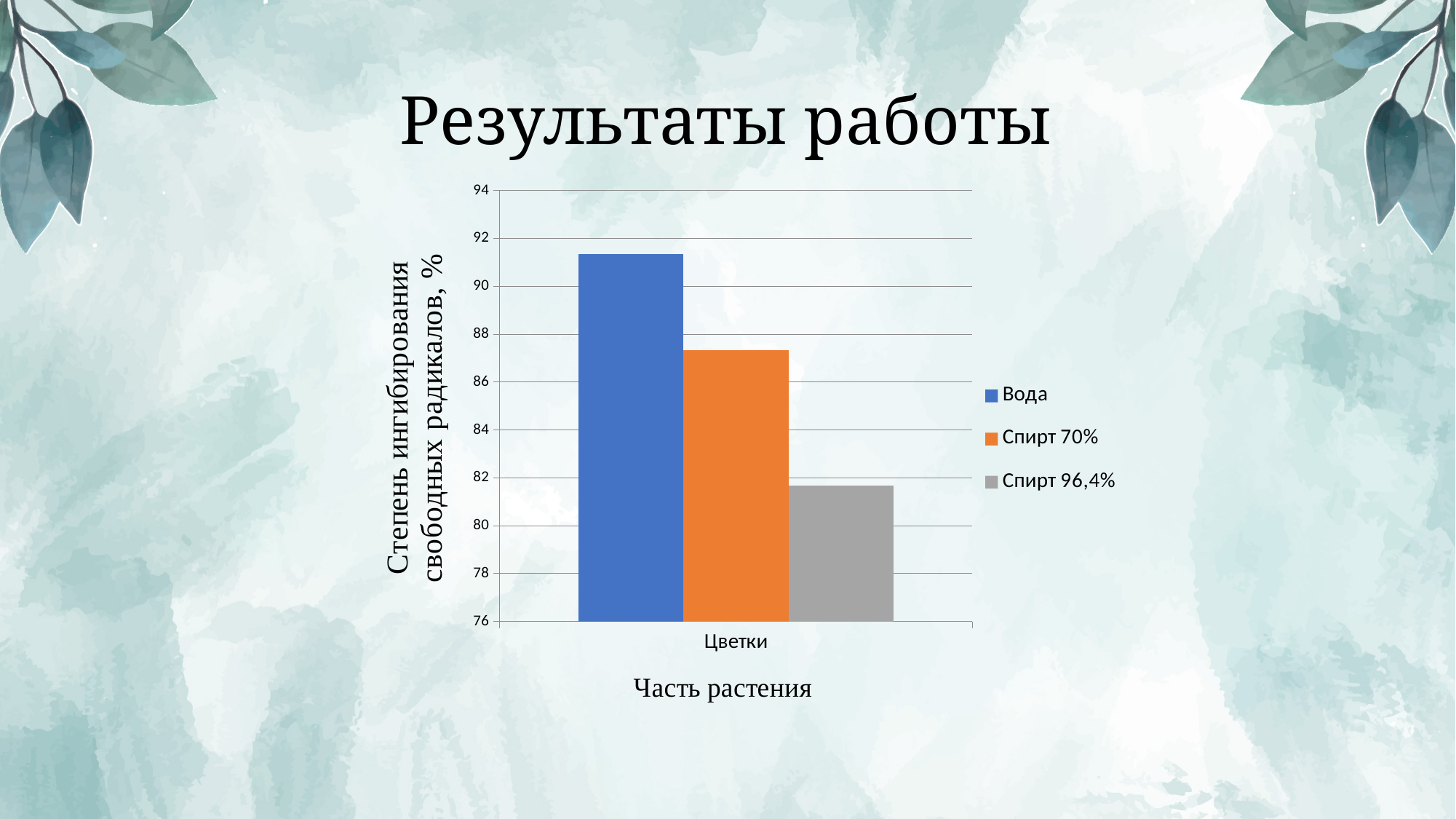
How many series does the legend list? 3 What kind of chart is shown on the slide? bar chart What is the label of the x axis? Часть растения Which is larger for Цветки: the value for Спирт 70% or the value for Спирт 96,4%? Спирт 70% Is the value for Спирт 70% greater or less than 88? less Which series has the highest value for Цветки? Вода What colour represents the series Спирт 70% in the legend? orange Which series has the lowest value for Цветки? Спирт 96,4% How many categories are shown on the x axis? 1 Is the value for Вода greater or less than 90? greater Is the value for Спирт 96,4% greater or less than 80? greater Which is larger for Цветки: the value for Вода or the value for Спирт 70%? Вода